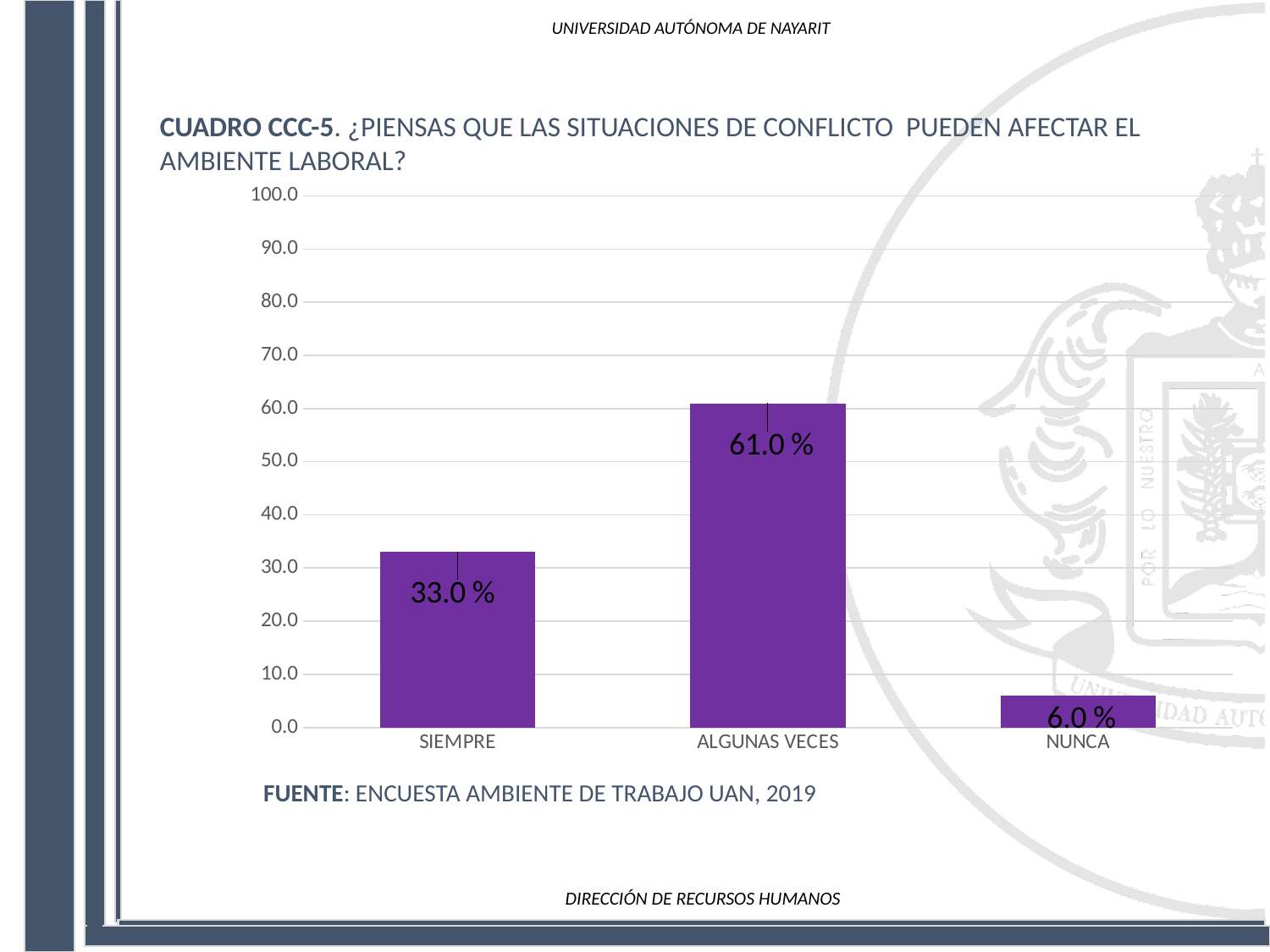
What source is cited below the chart? ENCUESTA AMBIENTE DE TRABAJO UAN, 2019 Which category has the highest value? ALGUNAS VECES What is the value for NUNCA? 6.0 % Is the value for ALGUNAS VECES greater or less than 50.0? greater What kind of chart is shown on the slide? bar chart What is the value for ALGUNAS VECES? 61.0 % Which category has the lowest value? NUNCA What is the difference between the values for SIEMPRE and NUNCA? 27.0 % What is the difference between the values for ALGUNAS VECES and SIEMPRE? 28.0 % How many categories are shown on the x axis? 3 Which is larger, the value for SIEMPRE or the value for NUNCA? SIEMPRE What is the value for SIEMPRE? 33.0 %